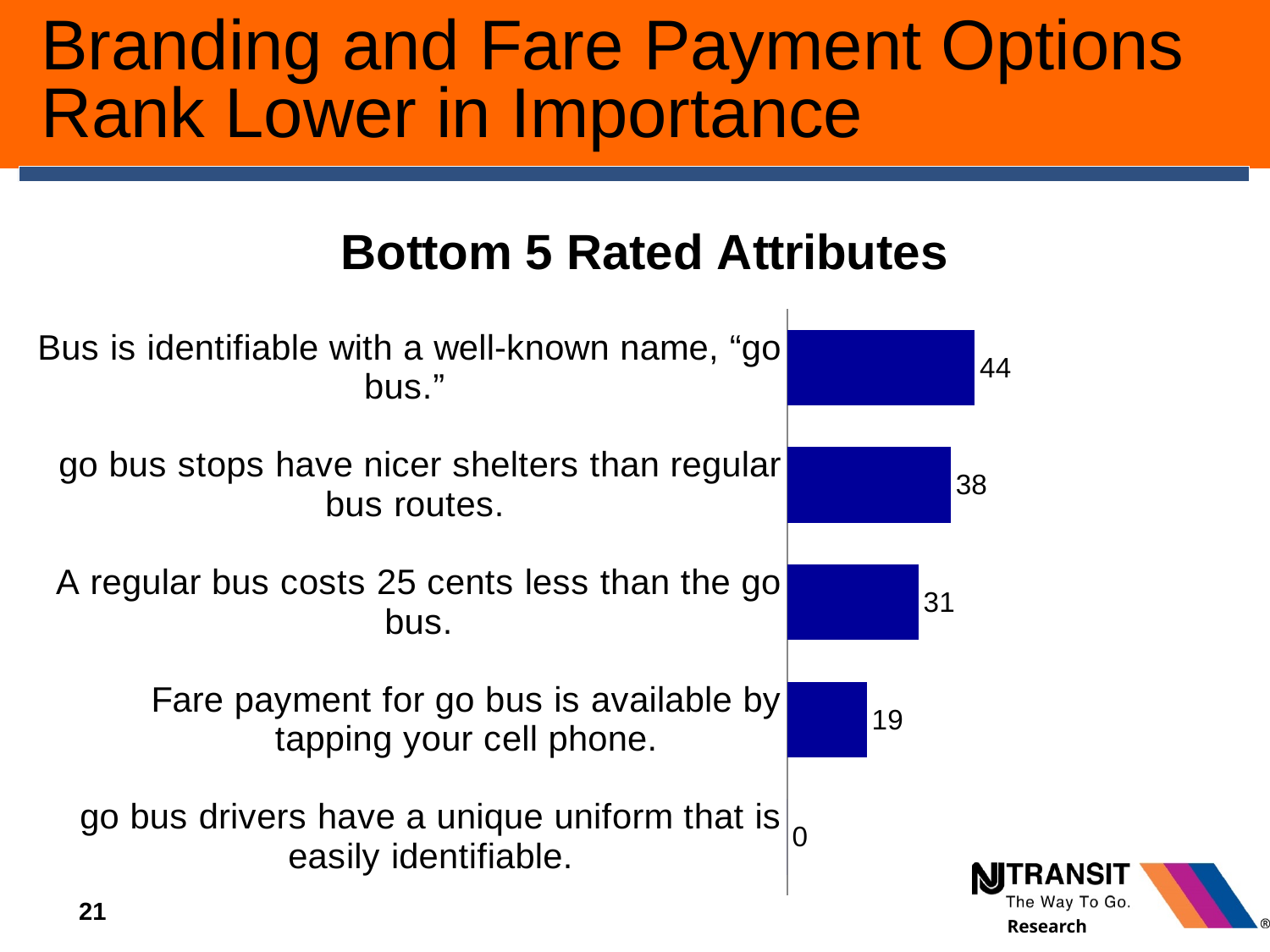
What is the value for "Fare payment for go bus is available by tapping your cell phone."? 19 How many attributes are shown in the chart? 5 Which has a larger value: "go bus stops have nicer shelters than regular bus routes." or "Fare payment for go bus is available by tapping your cell phone."? go bus stops have nicer shelters than regular bus routes. What is the title of the chart? Bottom 5 Rated Attributes What is the value for "Bus is identifiable with a well-known name, "go bus.""? 44 Which attribute has the highest value? Bus is identifiable with a well-known name, "go bus." What is the difference between the values for "Bus is identifiable with a well-known name, "go bus."" and "A regular bus costs 25 cents less than the go bus."? 13 Which attribute has the lowest value? go bus drivers have a unique uniform that is easily identifiable. What kind of chart is shown on the slide? Bar chart What is the value for "go bus drivers have a unique uniform that is easily identifiable."? 0 What is the value for "go bus stops have nicer shelters than regular bus routes."? 38 What is the difference between the values for "go bus stops have nicer shelters than regular bus routes." and "Fare payment for go bus is available by tapping your cell phone."? 19